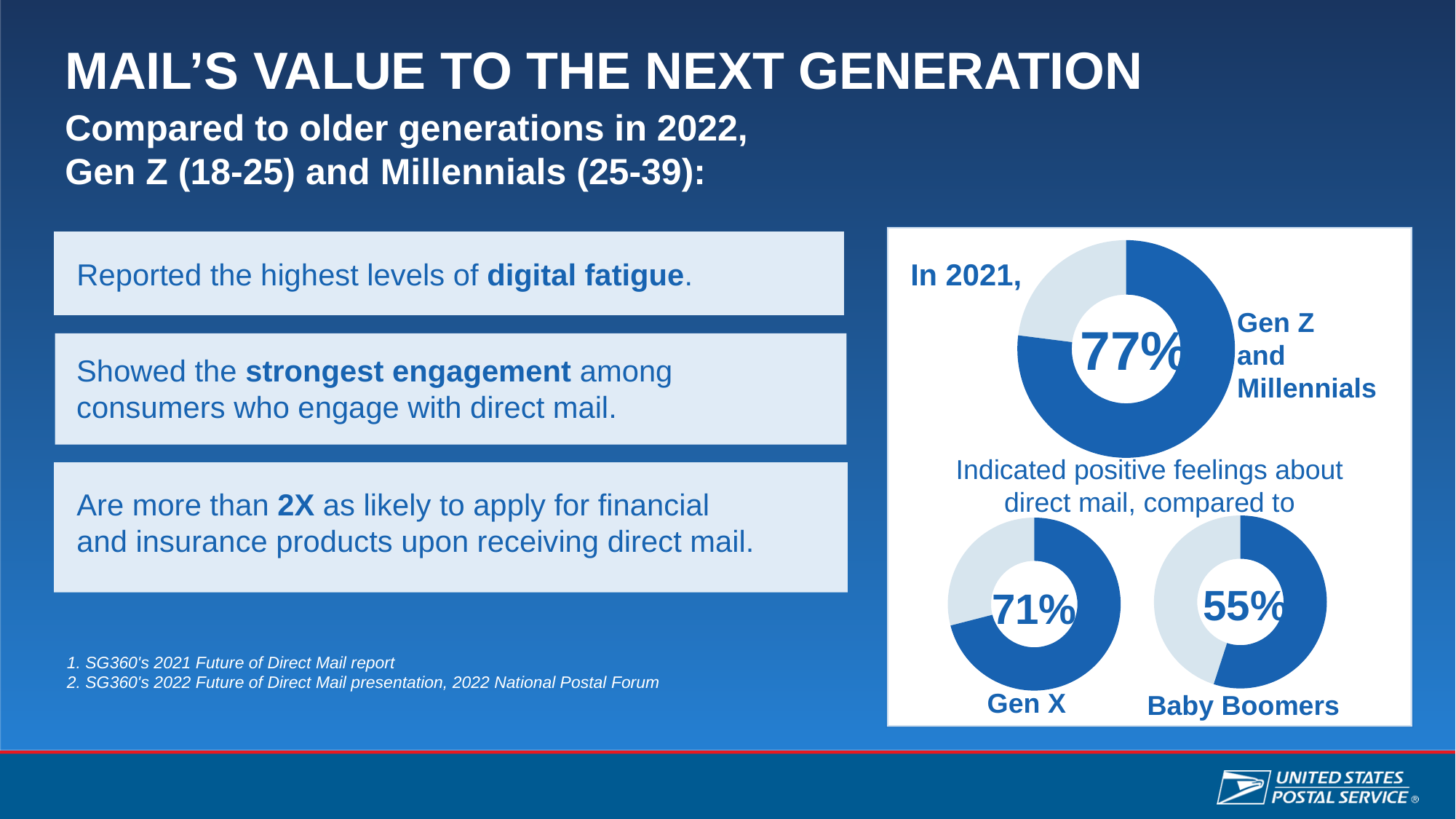
What is the difference in percentage points between Gen X and Baby Boomers for positive feelings about direct mail? 16 percentage points What percentage of Baby Boomers indicated positive feelings about direct mail? 55% Which generation group shows the lowest share of positive feelings about direct mail? Baby Boomers Which year do the donut charts on the right refer to? 2021 What kind of chart is used to show the 77%, 71% and 55% values? Donut (pie) chart What do the donut charts on the right measure? Positive feelings about direct mail What percentage of Gen Z and Millennials indicated positive feelings about direct mail in 2021? 77% What is the difference in percentage points between Gen Z and Millennials and Baby Boomers for positive feelings about direct mail? 22 percentage points What percentage of Gen X indicated positive feelings about direct mail? 71% Which generation group shows the highest share of positive feelings about direct mail? Gen Z and Millennials Which has a higher share of positive feelings about direct mail, Gen X or Baby Boomers? Gen X How many donut charts are shown in the white panel on the right of the slide? 3